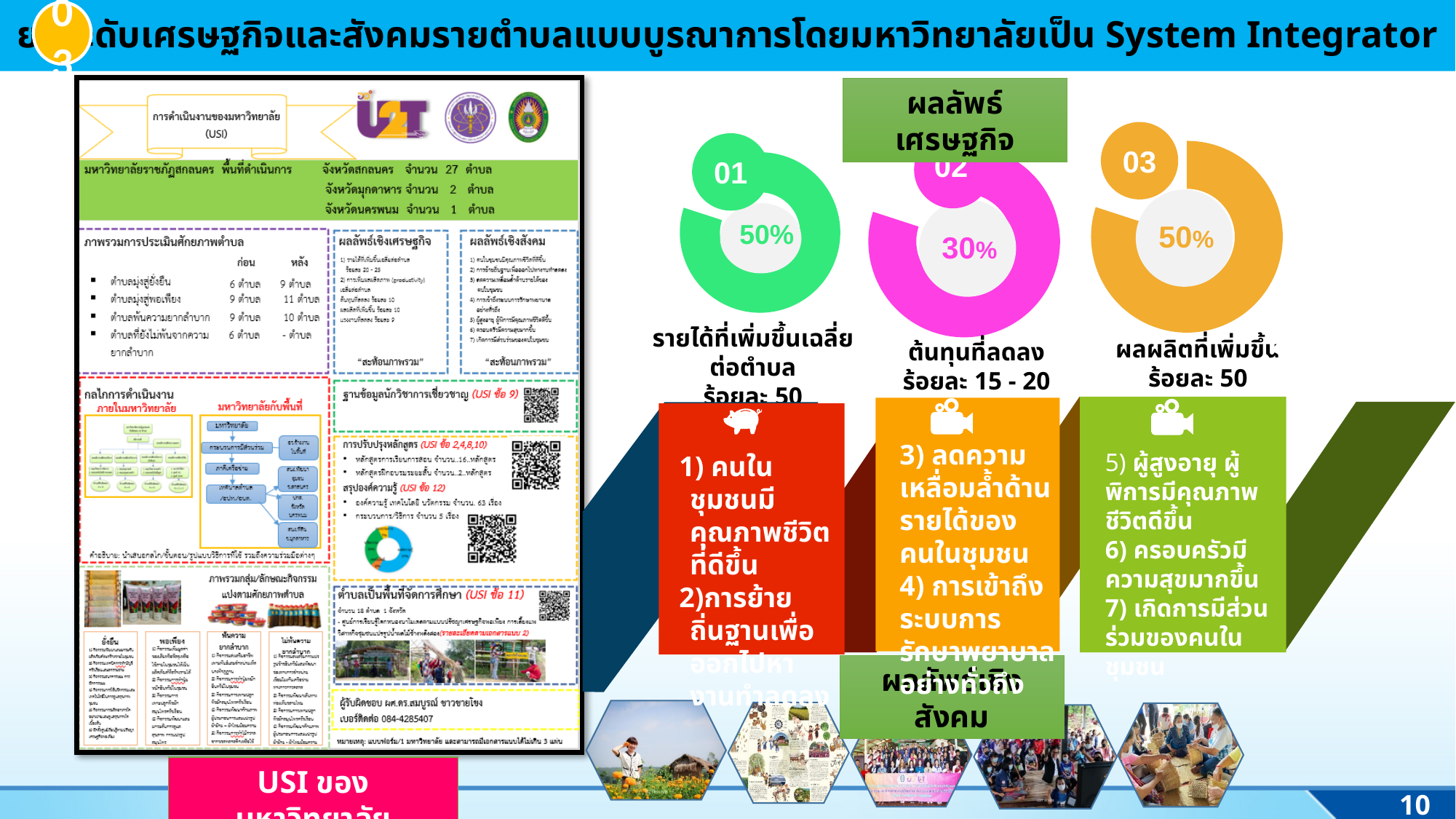
How many donut charts are shown on the right side of the slide under the heading ผลลัพธ์เศรษฐกิจ? 3 What percentage is shown in the centre of the pink donut chart labelled 02? 30% What colour is the donut chart labelled 03? orange What is the difference between the percentage in the green donut chart (01) and the pink donut chart (02)? 20% Is the value in the pink donut chart (02) greater or less than 50%? less Which of the three numbered donut charts (01, 02, 03) shows the lowest percentage? 02 Is the percentage in the pink donut chart (02) larger or smaller than the percentage in the green donut chart (01)? smaller What percentage is shown in the centre of the orange donut chart labelled 03? 50% What type of chart is used to display the 50%, 30% and 50% values on the right side of the slide? donut chart What percentage is shown in the centre of the green donut chart labelled 01 on the right side of the slide? 50% What is the caption below the green donut chart labelled 01? รายได้ที่เพิ่มขึ้นเฉลี่ยต่อตำบล ร้อยละ 50